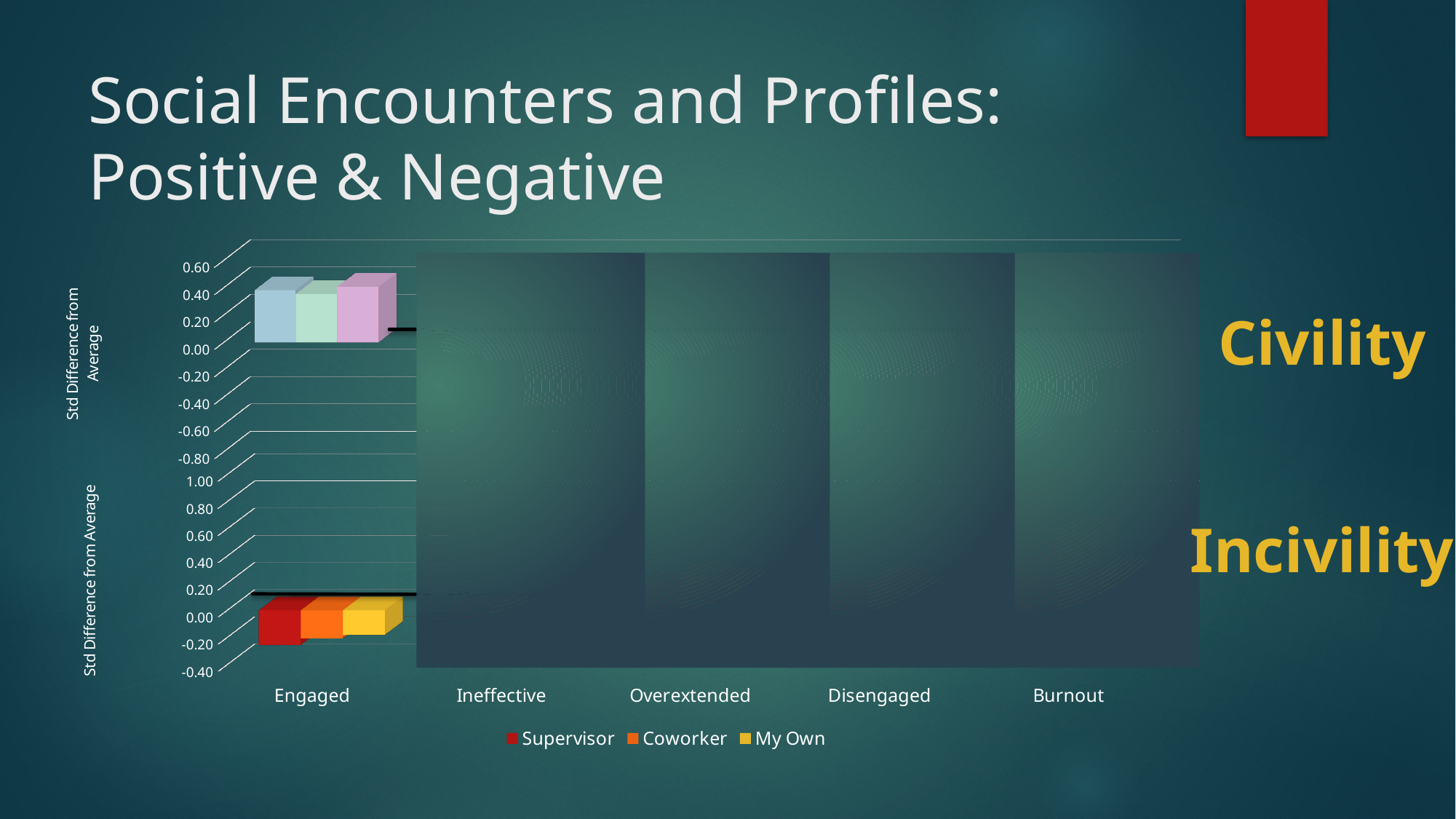
In the Incivility chart, is the value for Coworker in the Engaged category greater or less than 0.40? less How many series does the legend list? 3 What are the three series named in the legend? Supervisor, Coworker, My Own What is the title of the vertical axis on the charts? Std Difference from Average In the Incivility chart, is the value for Supervisor in the Engaged category greater or less than 0.20? less How many categories are shown along the x axis? 5 What kind of chart is used on this slide for the Civility and Incivility data? Bar chart